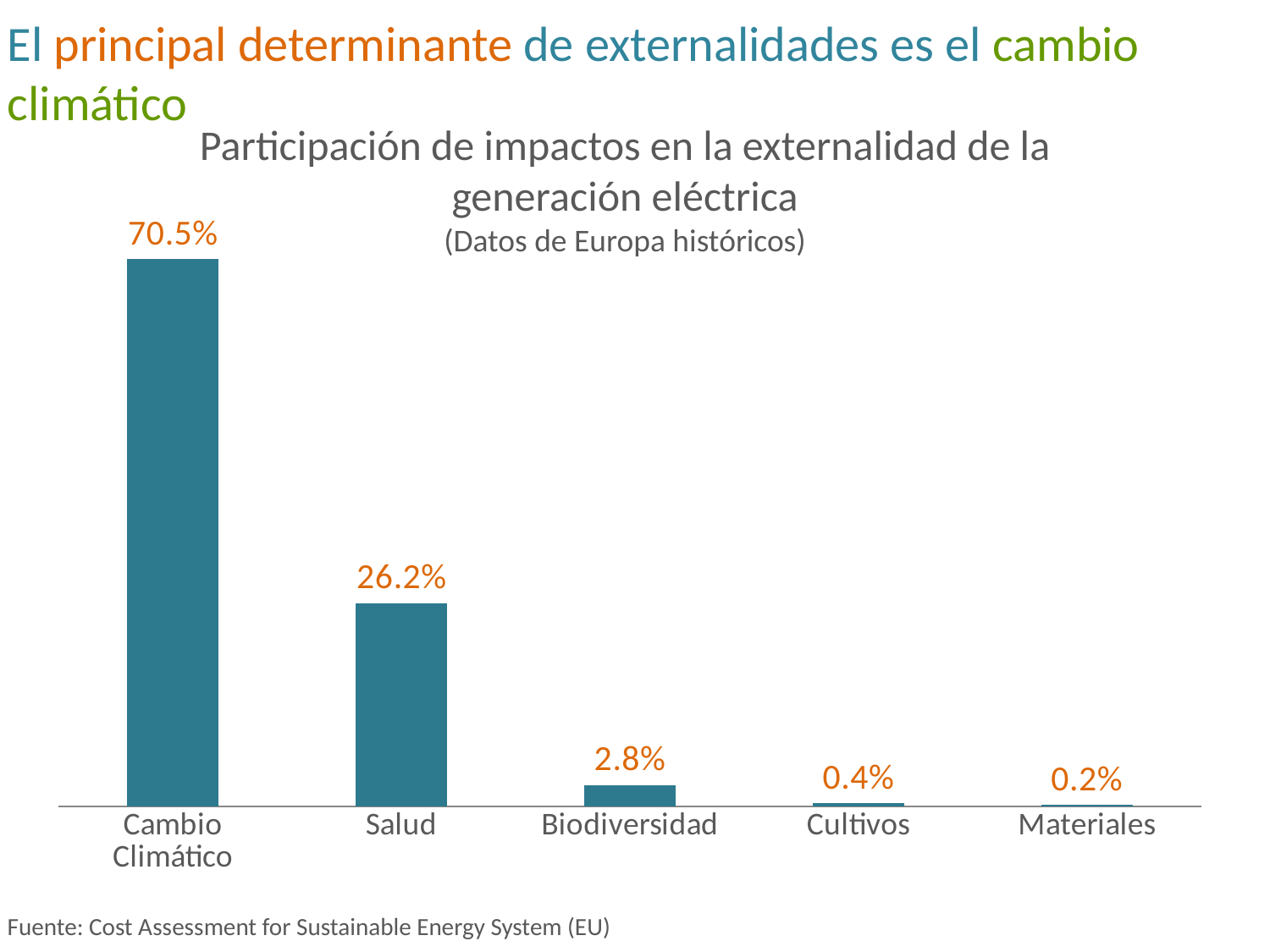
How many categories are shown in the chart? 5 What kind of chart is shown on the slide? Bar chart Which category has the lowest value? Materiales What is the value for Salud? 26.2% What is the value for Materiales? 0.2% What is the value for Cambio Climático? 70.5% What is the value for Biodiversidad? 2.8% Which is larger, the value for Salud or the value for Biodiversidad? Salud Which category has the highest value? Cambio Climático What is the difference between the values for Cambio Climático and Salud? 44.3% What is the title of the chart? Participación de impactos en la externalidad de la generación eléctrica (Datos de Europa históricos) What is the value for Cultivos? 0.4%